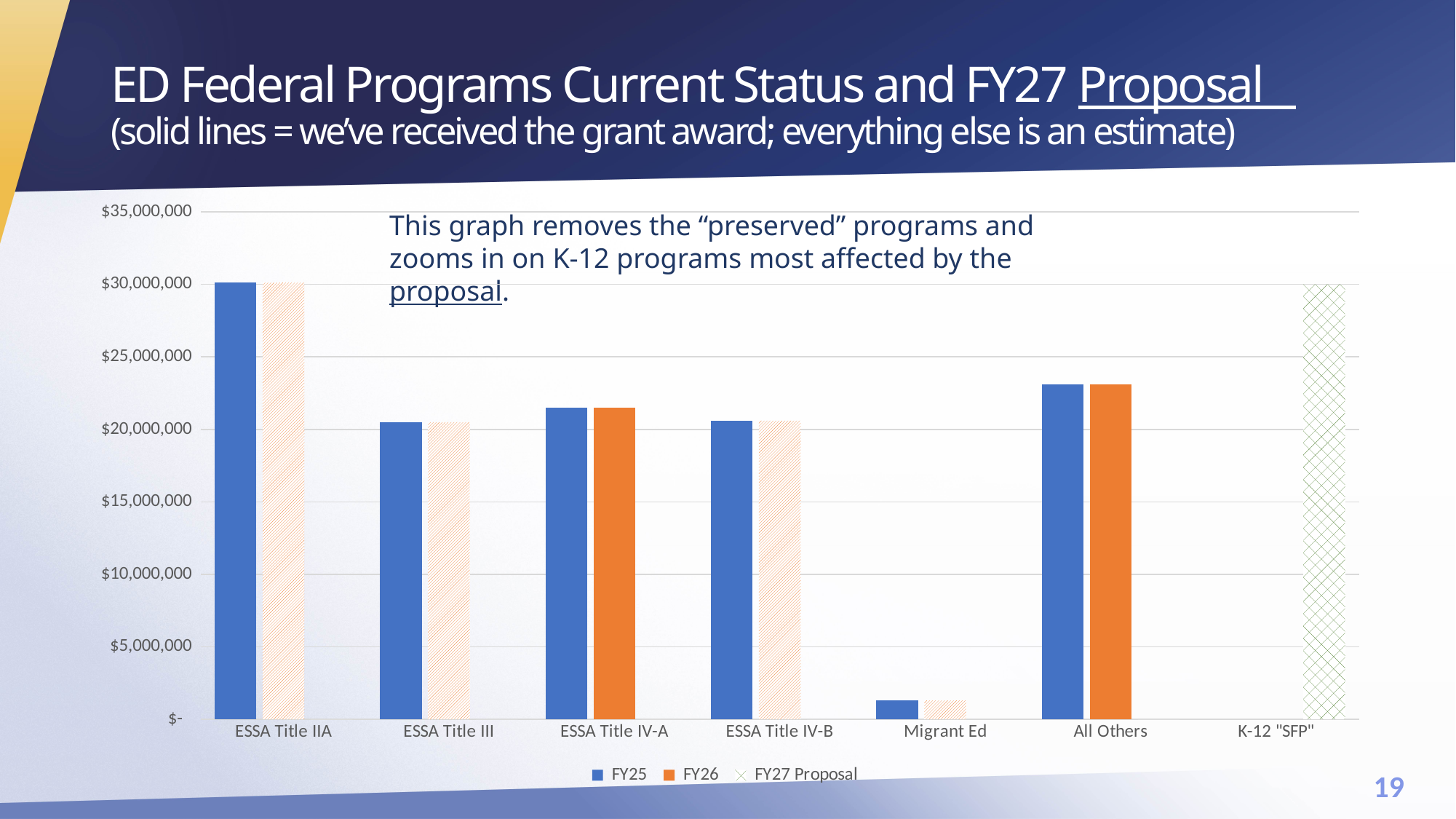
How many series does the chart legend list? 3 Is the FY25 value for Migrant Ed greater or less than $5,000,000? less How many program categories are shown on the x axis of the chart? 7 Is the FY25 value for All Others greater or less than $20,000,000? greater Which is larger, the FY25 value for Migrant Ed or the FY25 value for ESSA Title III? ESSA Title III Which is larger, the FY25 value for ESSA Title IIA or the FY25 value for All Others? ESSA Title IIA Is the FY25 value for ESSA Title IIA greater or less than $25,000,000? greater Which program has the highest FY25 value in the chart? ESSA Title IIA Which program has the lowest FY25 value in the chart? Migrant Ed What are the three series listed in the chart legend? FY25, FY26, FY27 Proposal What kind of chart is shown on the slide? Bar chart